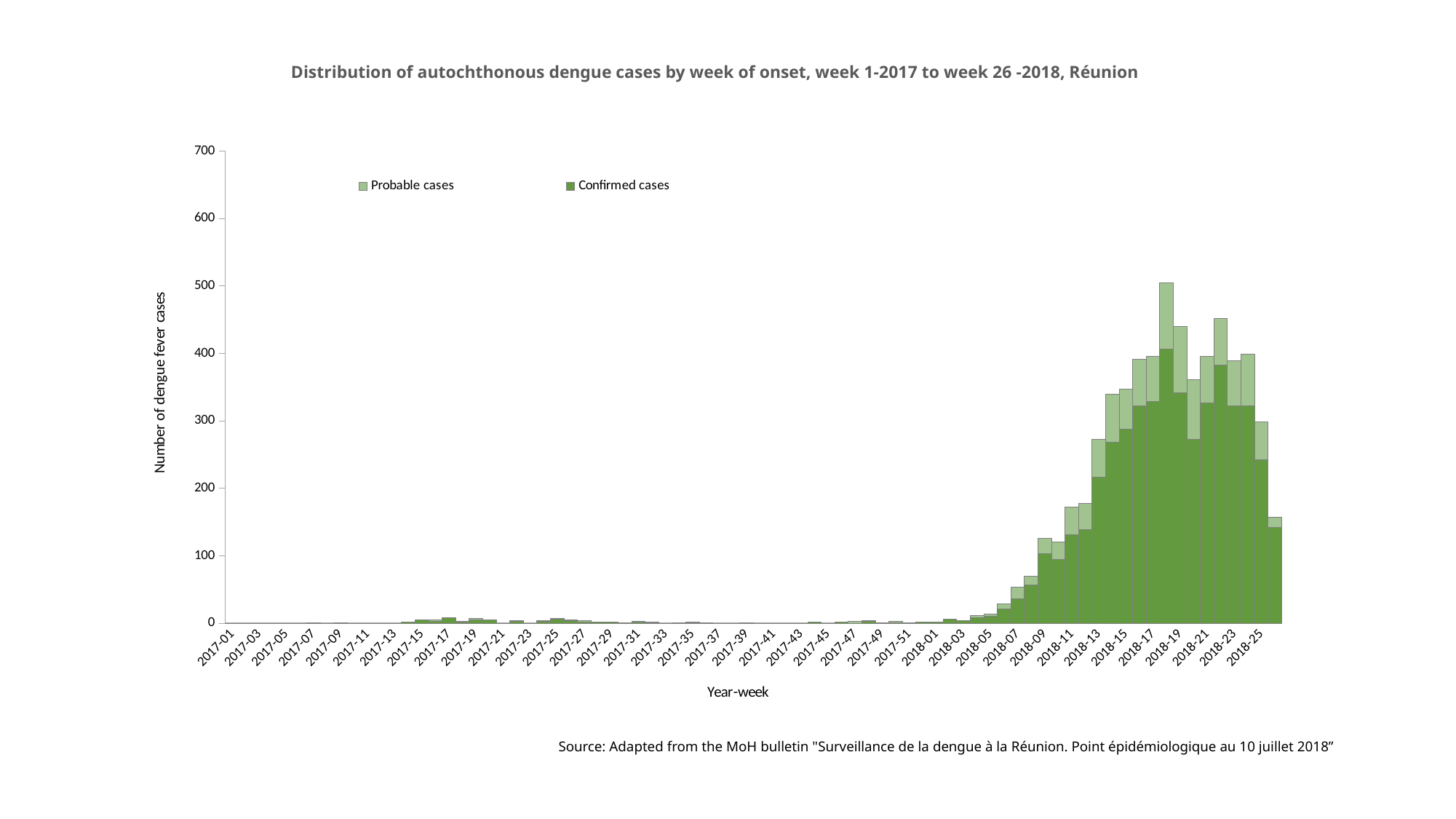
In the tallest bar, which series accounts for the larger share: Probable cases or Confirmed cases? Confirmed cases Is the total number of cases for week 2018-05 greater or less than 100? less What is the title of the vertical axis? Number of dengue fever cases Is the total number of cases for week 2018-13 greater or less than 200? greater Do the weekly case counts rise or fall between week 2018-01 and week 2018-17? rise How many series does the legend list? 2 What are the two series named in the legend? Probable cases and Confirmed cases Is the total number of cases for week 2018-21 greater or less than 300? greater Which year shows more dengue cases overall, 2017 or 2018? 2018 What kind of chart is shown on the slide? Stacked bar chart